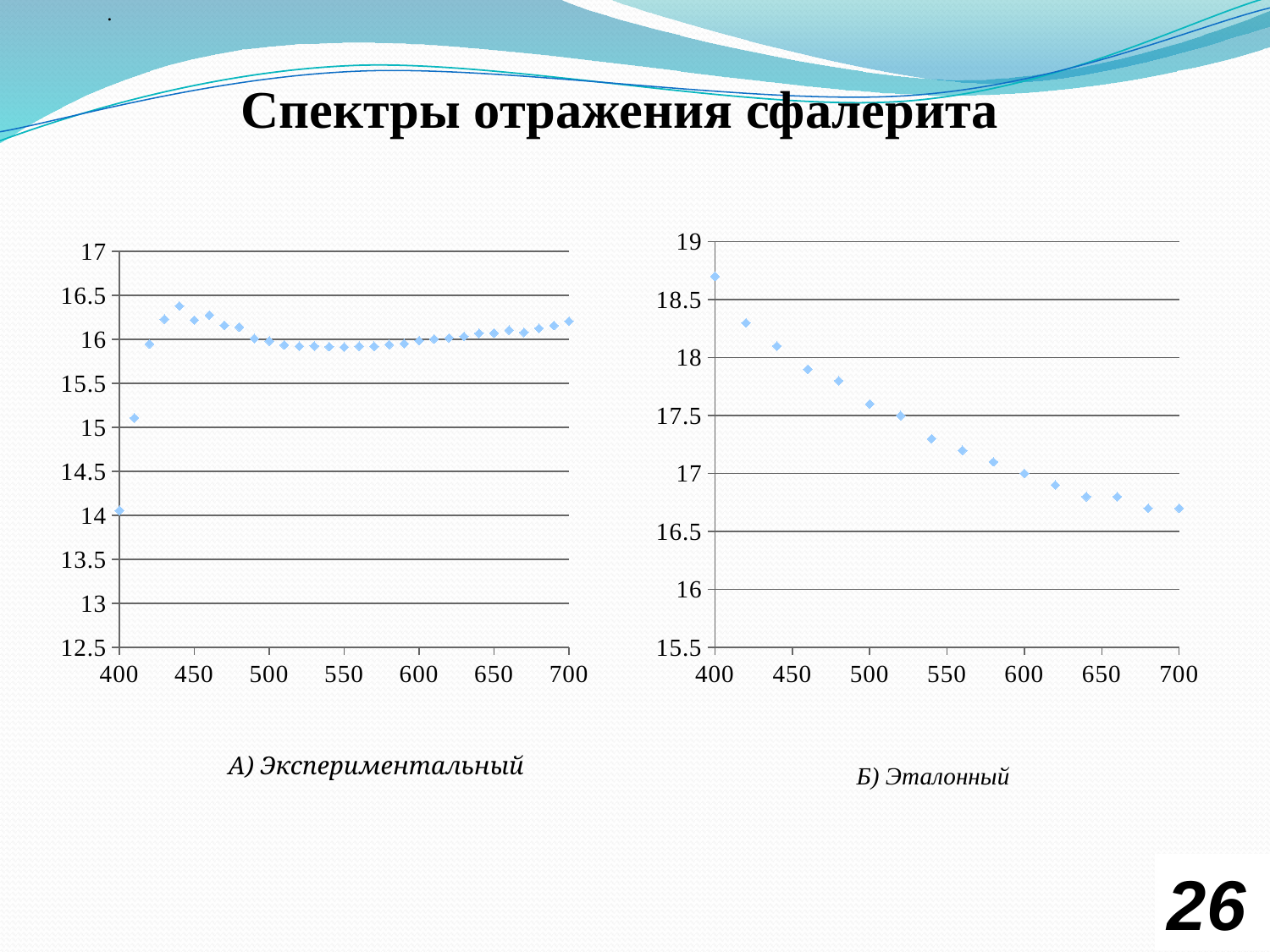
What kind of chart is the right chart (Б) Эталонный)? scatter chart In the right chart (Б) Эталонный), do the values rise or fall as x increases from 400 to 700? fall In the right chart (Б) Эталонный), is the value at 560 greater or less than 17.5? less What kind of chart is the left chart (А) Экспериментальный)? scatter chart What is the title of the slide above the two charts? Спектры отражения сфалерита In the right chart (Б) Эталонный), which is larger: the value at 400 or the value at 700? 400 In the right chart (Б) Эталонный), is the value at 700 greater or less than 17? less In the left chart (А) Экспериментальный), at which x value is the lowest point? 400 In the right chart (Б) Эталонный), at which x value is the highest point? 400 In the right chart (Б) Эталонный), is the value at 400 greater or less than 18.5? greater